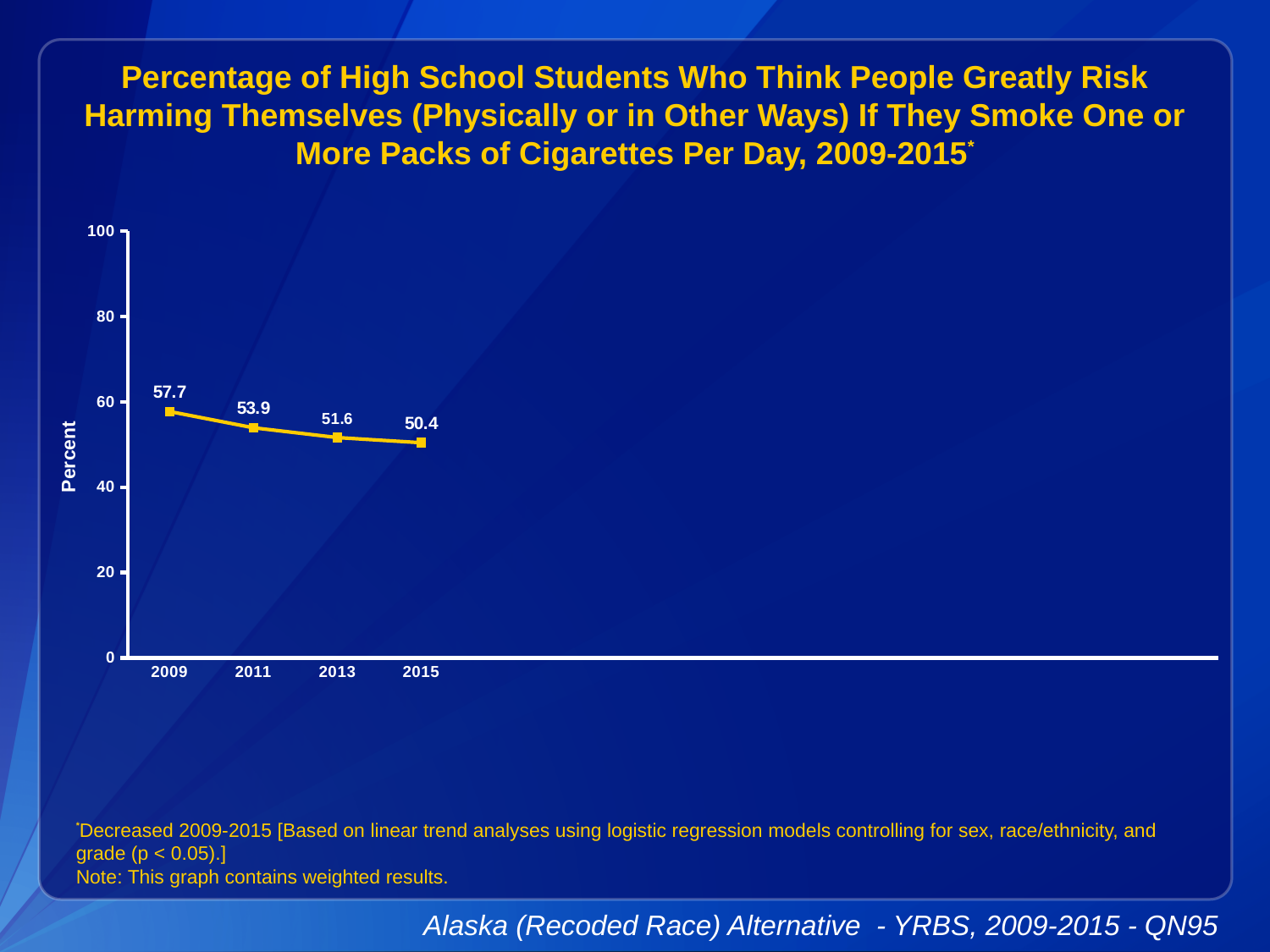
How many years are plotted on the chart? 4 What is the value for 2011? 53.9 What is the value for 2013? 51.6 Which is larger, the value for 2011 or the value for 2013? 2011 Which year has the lowest value? 2015 What kind of chart is shown on the slide? line chart What is the value for 2015? 50.4 What is the value for 2009? 57.7 Which year has the highest value? 2009 Is the value for 2009 greater or less than 60? less Do the values rise or fall from 2009 to 2015? fall What is the difference between the values for 2009 and 2015? 7.3